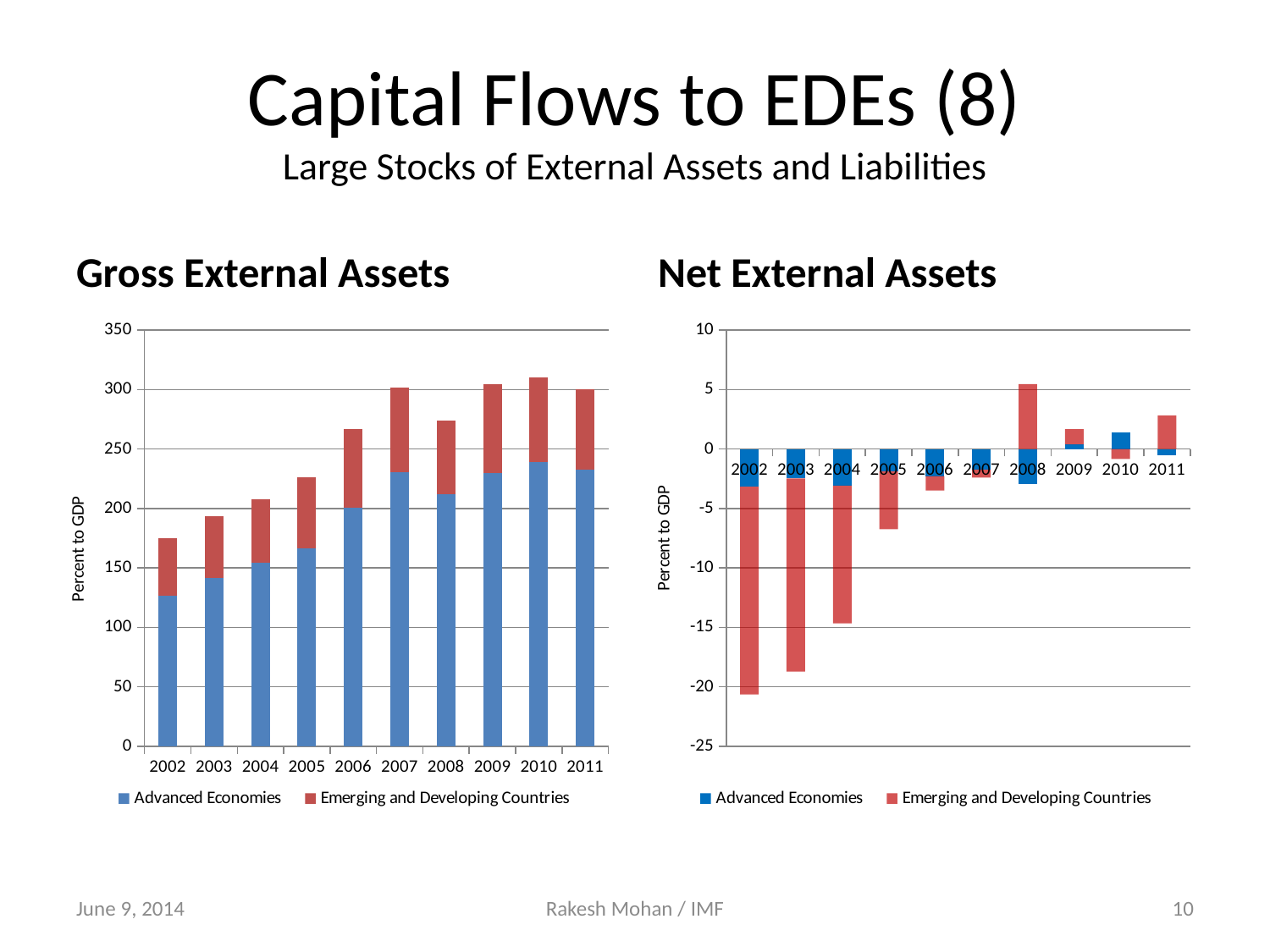
In the Gross External Assets chart, is the total for 2002 greater or less than 200? less In the Gross External Assets chart, is the Advanced Economies value for 2002 greater or less than 150? less How many series does the legend of the Net External Assets chart list? 2 In the Gross External Assets chart, do the total stacked values generally rise or fall from 2002 to 2010? rise How many years are shown on the x axis of the Gross External Assets chart? 10 In the Net External Assets chart, which year has the highest Emerging and Developing Countries value? 2008 In the Net External Assets chart, which year has the lowest Emerging and Developing Countries value? 2002 In the Net External Assets chart, is the Emerging and Developing Countries value for 2003 greater or less than -15? less What is the y-axis label on the Net External Assets chart? Percent to GDP What type of chart is the Gross External Assets chart? Stacked bar chart In the Gross External Assets chart, which year has the lowest total stacked bar? 2002